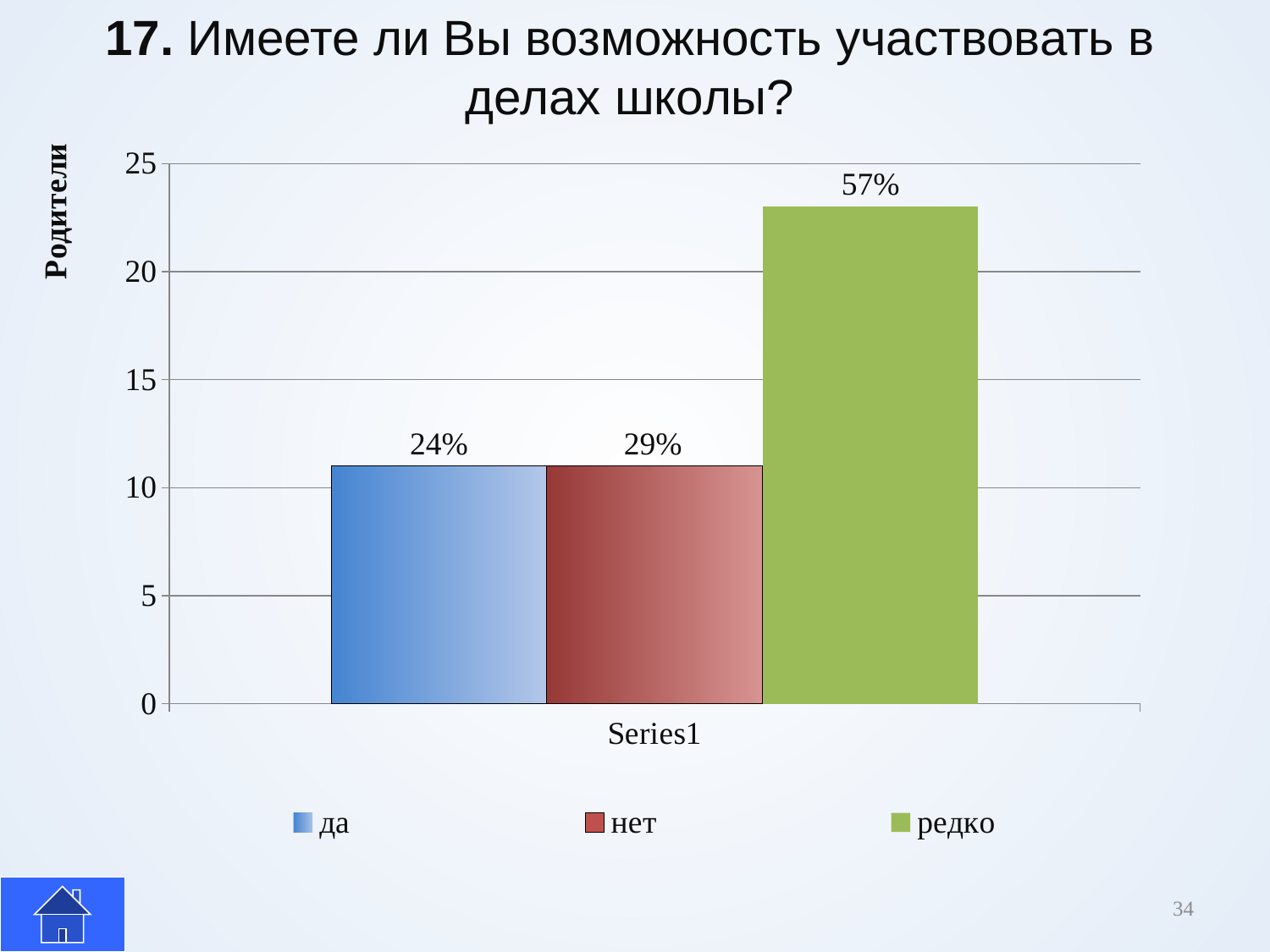
What is the difference between the labelled values for "редко" and "да"? 33% How many series does the legend list? 3 What is the label on the vertical axis of the chart? Родители Is the bar for "редко" greater or less than 20 on the vertical axis? greater Is the bar for "да" greater or less than 15 on the vertical axis? less What kind of chart is shown on the slide? bar chart What is the difference between the labelled values for "нет" and "да"? 5% What is the data label shown on the bar for "да"? 24% Which legend entry has the highest value? редко What is the data label shown on the bar for "редко"? 57% Which legend entry has the lowest labelled value? да What is the data label shown on the bar for "нет"? 29%